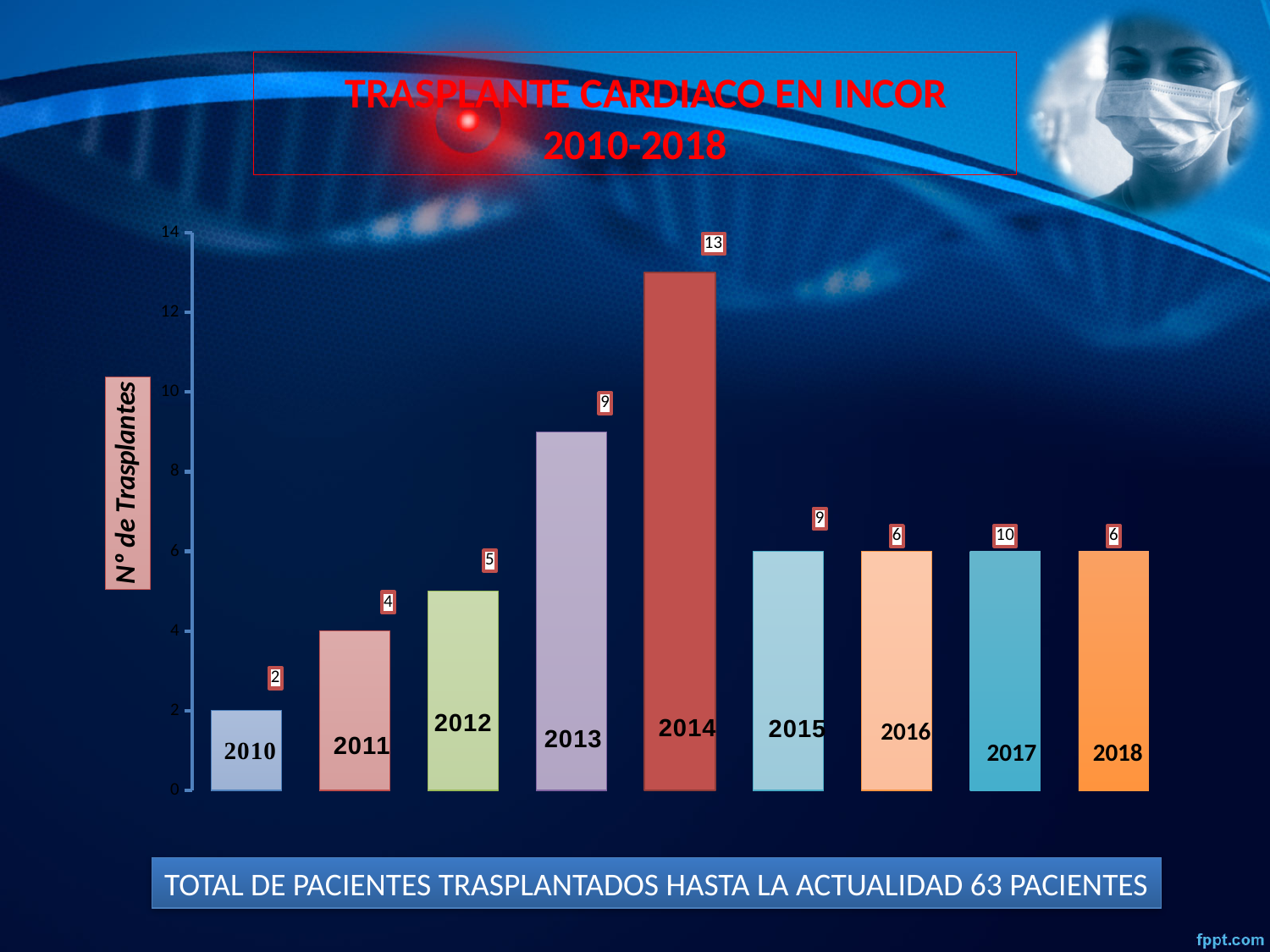
What is the value for 2012? 5 What is the difference between the values for 2014 and 2013? 4 Which year has the highest number of transplants? 2014 What kind of chart is shown on the slide? bar chart Which is larger, the value for 2011 or the value for 2013? 2013 How many heart transplants were performed in 2014? 13 What is the value for 2016? 6 How many years are shown on the x axis? 9 What is the value for 2010? 2 Do the values rise or fall from 2010 to 2014? rise Which year has the lowest number of transplants? 2010 What is the label on the vertical axis? N° de Trasplantes